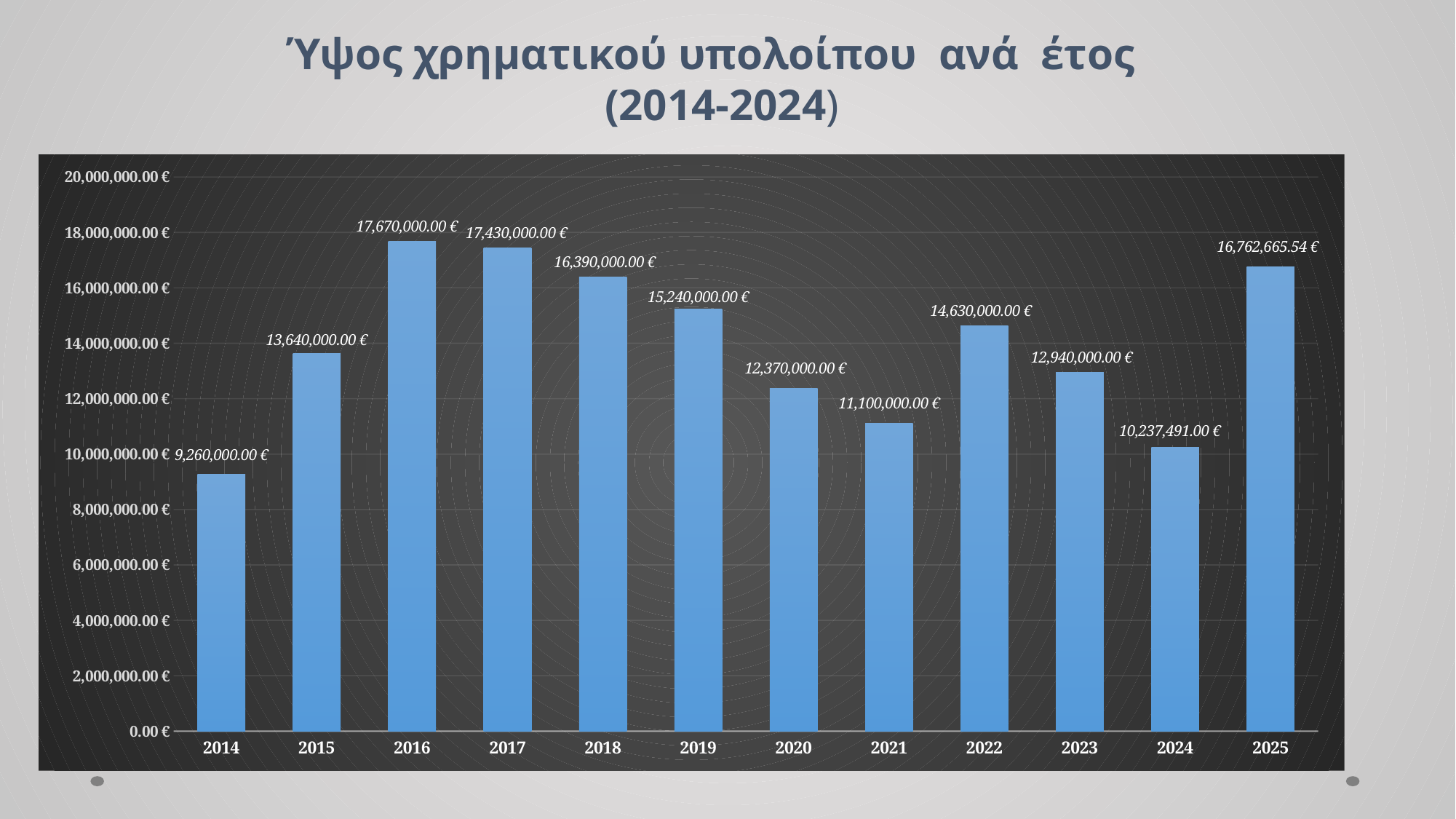
Which year has the highest value? 2016 What is the difference between the values for 2022 and 2023? 1,690,000.00 € What kind of chart is shown on the slide? bar chart What is the value for 2025? 16,762,665.54 € Do the values rise or fall from 2016 to 2021? fall Which is larger, the value for 2018 or the value for 2019? 2018 What is the value for 2024? 10,237,491.00 € What is the value for 2014? 9,260,000.00 € What is the difference between the values for 2016 and 2017? 240,000.00 € Which year has the lowest value? 2014 How many years are shown on the x axis? 12 Is the value for 2021 greater or less than 12,000,000.00 €? less